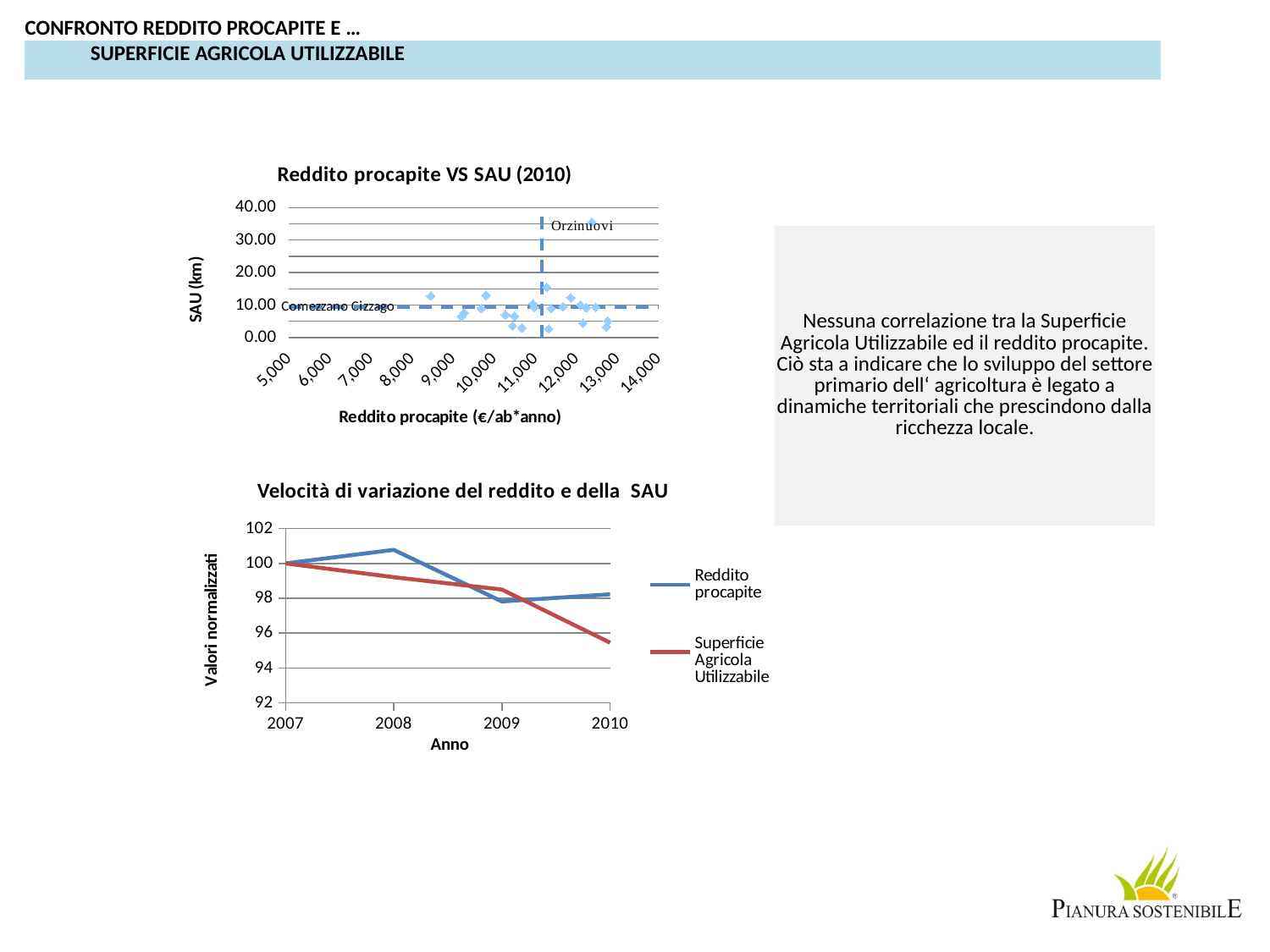
In the chart 'Velocità di variazione del reddito e della SAU', in which year is 'Superficie Agricola Utilizzabile' lowest? 2010 In the chart 'Velocità di variazione del reddito e della SAU', what is the value of 'Superficie Agricola Utilizzabile' in 2007? 100 In the chart 'Velocità di variazione del reddito e della SAU', does the 'Superficie Agricola Utilizzabile' line rise or fall from 2007 to 2010? fall In the chart 'Velocità di variazione del reddito e della SAU', is the value of 'Superficie Agricola Utilizzabile' in 2010 greater or less than 96? less In the chart 'Reddito procapite VS SAU (2010)', is the SAU value for Orzinuovi greater or less than 30.00? greater In the chart 'Velocità di variazione del reddito e della SAU', how many years are shown on the x axis? 4 What type of chart is 'Reddito procapite VS SAU (2010)'? scatter chart What type of chart is 'Velocità di variazione del reddito e della SAU'? line chart What is the x-axis label of the chart 'Reddito procapite VS SAU (2010)'? Reddito procapite (€/ab*anno) In the chart 'Velocità di variazione del reddito e della SAU', is the value of 'Reddito procapite' in 2008 greater or less than 100? greater In the chart 'Velocità di variazione del reddito e della SAU', how many series does the legend list? 2 In the chart 'Velocità di variazione del reddito e della SAU', which series has the higher value in 2010, 'Reddito procapite' or 'Superficie Agricola Utilizzabile'? Reddito procapite